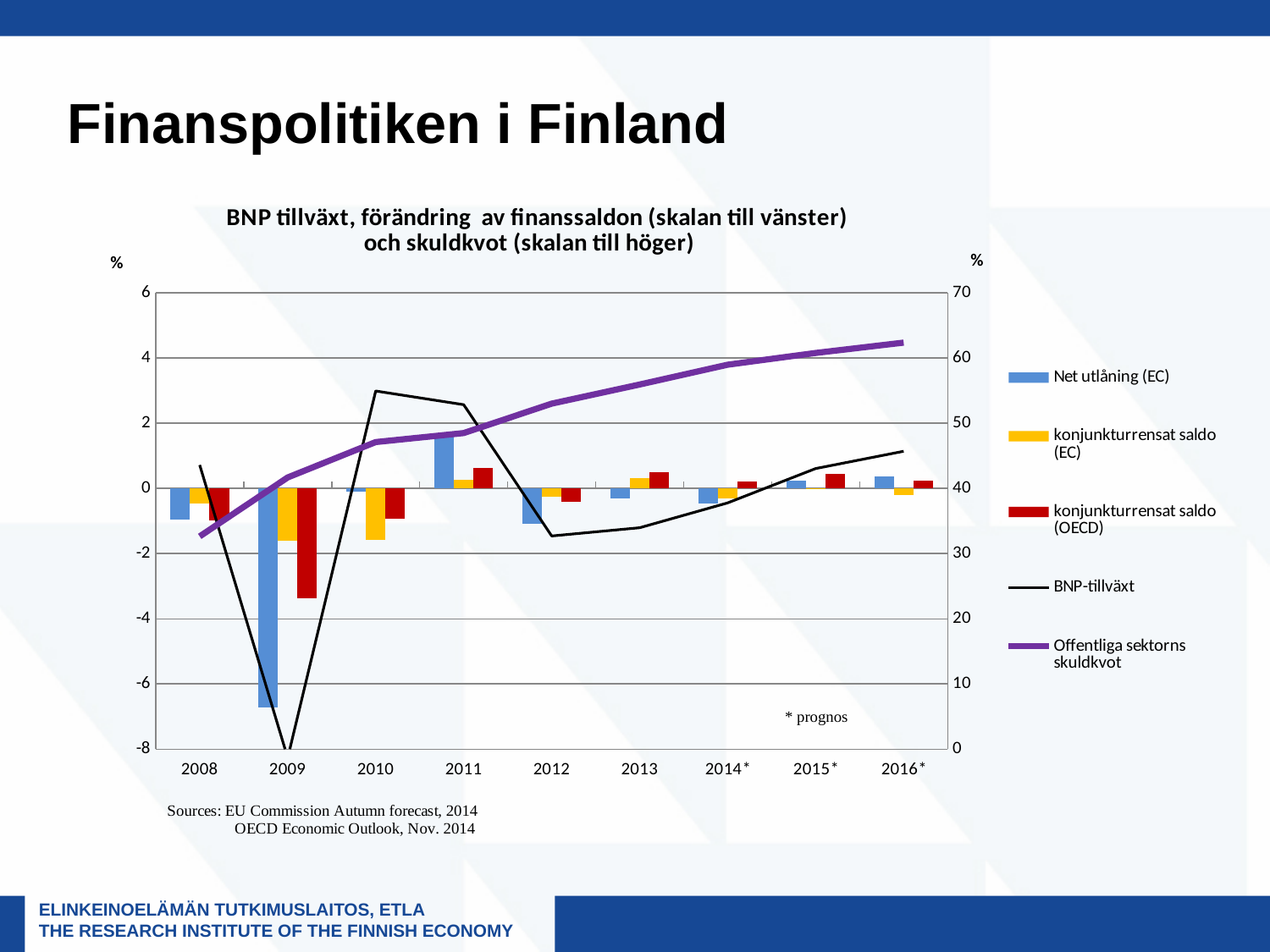
In which year does the BNP-tillväxt line reach its lowest point? 2009 How many years are shown along the x axis of the chart? 9 Is the Offentliga sektorns skuldkvot value for 2008 greater or less than 40 on the right-hand scale? less What kind of chart is shown on the slide? A combined bar and line chart In 2009, which bar is lower: Net utlåning (EC) or konjunkturrensat saldo (OECD)? Net utlåning (EC) Is the Offentliga sektorns skuldkvot value for 2016* greater or less than 60 on the right-hand scale? greater In which year is the Net utlåning (EC) bar lowest? 2009 Is the Net utlåning (EC) value for 2009 greater or less than -6? less Which legend entry is drawn as the thick purple line? Offentliga sektorns skuldkvot Does the Offentliga sektorns skuldkvot line rise or fall from 2008 to 2016*? rise How many series does the chart's legend list? 5 In which year is the Net utlåning (EC) bar highest? 2011